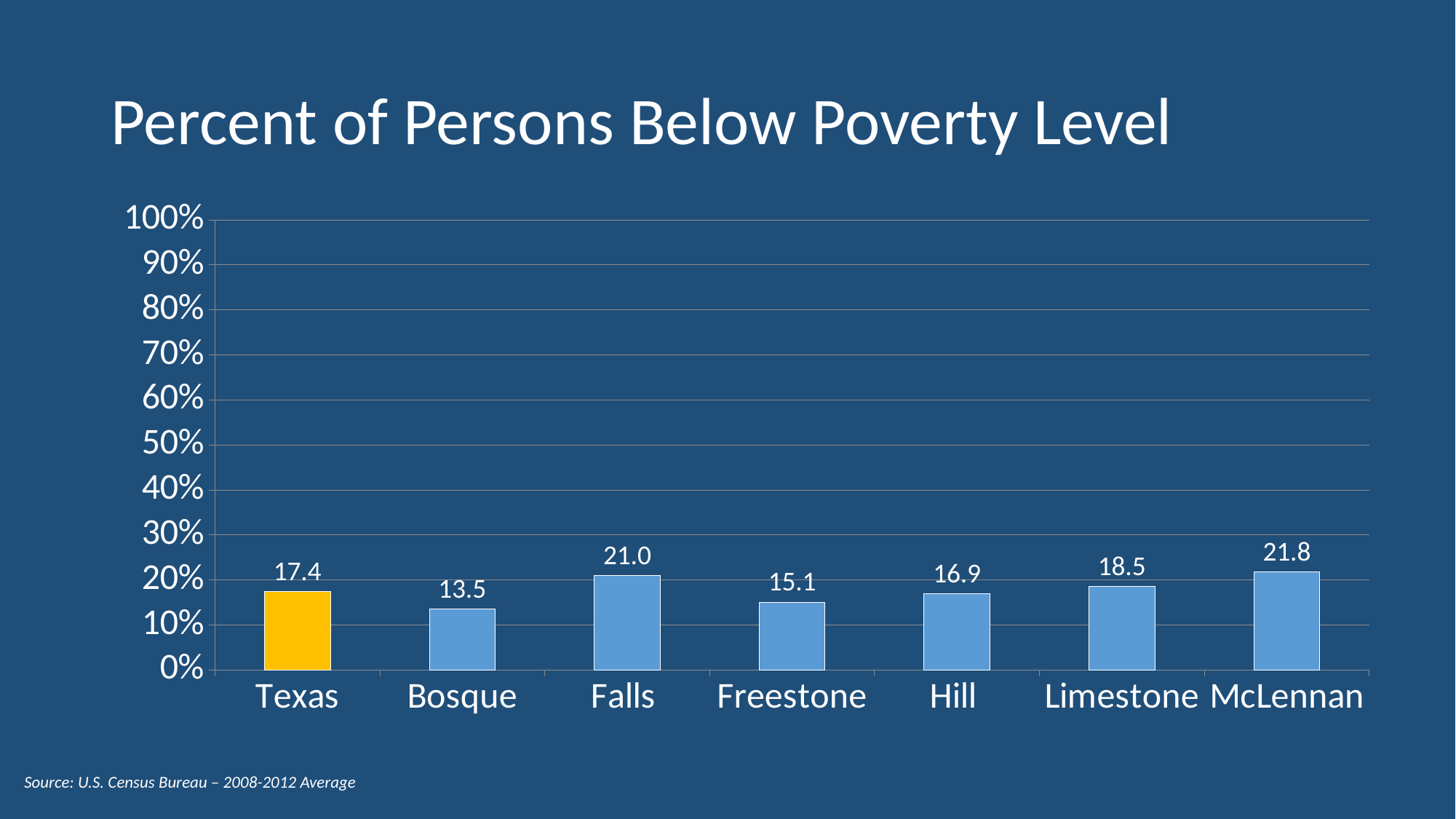
Is the value for Falls greater or less than 30%? less Which is larger, the value for Limestone or the value for Hill? Limestone What is the difference between the values for Falls and Texas? 3.6 Which category has the highest value? McLennan What kind of chart is shown on the slide? bar chart What is the value shown for Texas? 17.4 Which category has the lowest value? Bosque How many categories are shown on the x axis? 7 Which bar is coloured differently from the others? Texas What is the value shown for McLennan? 21.8 What is the value shown for Freestone? 15.1 What is the difference between the values for McLennan and Bosque? 8.3